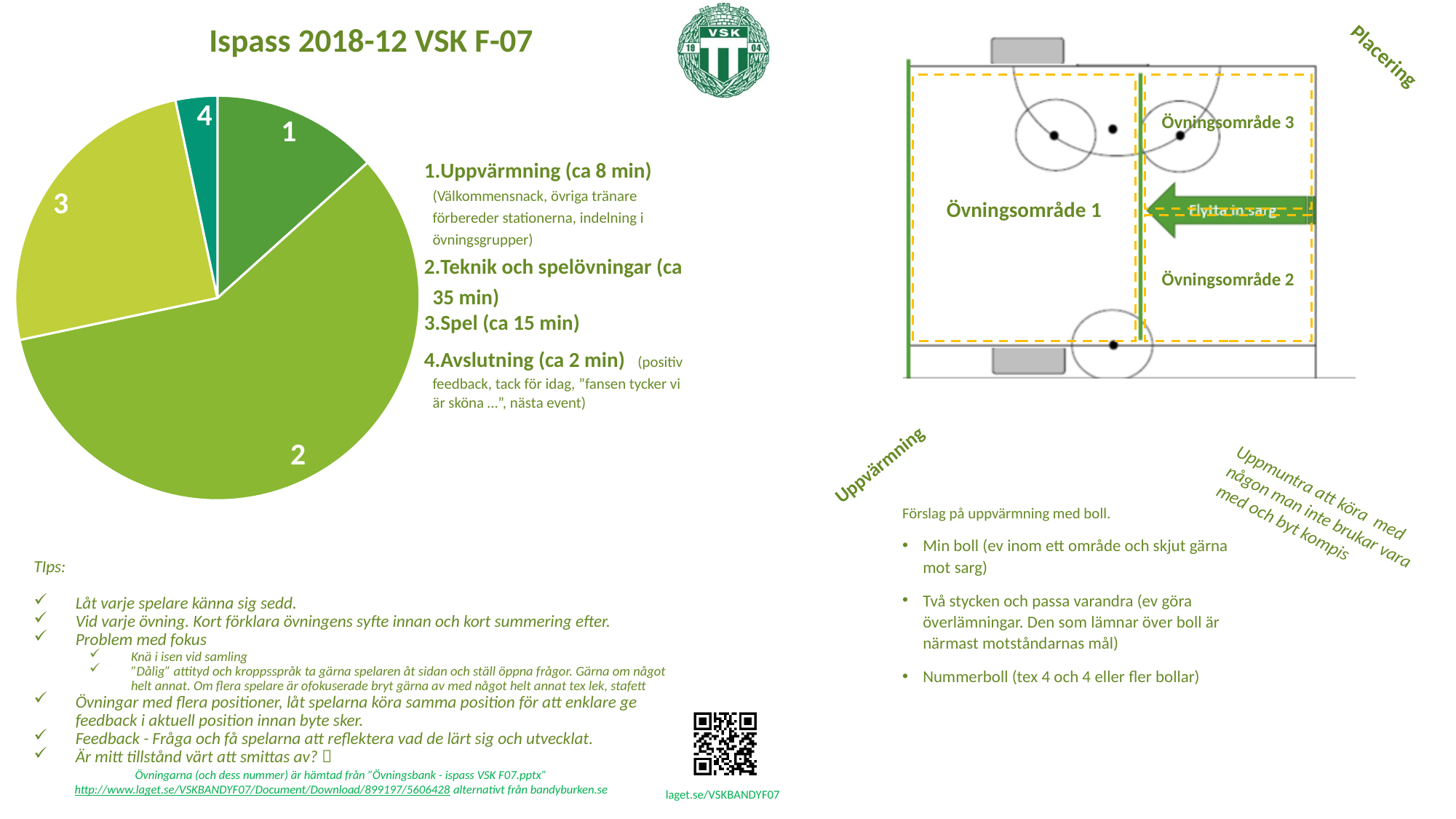
Which slice of the pie chart is the largest? 2 In the pie chart, which slice is larger, slice 1 or slice 4? 1 Does slice 2 of the pie chart take up more or less than half of the pie? more What colour is slice 4 of the pie chart? teal In the pie chart, which slice is larger, slice 2 or slice 3? 2 How many slices does the pie chart have? 4 What is the title of the slide containing the pie chart? Ispass 2018-12 VSK F-07 Which slice of the pie chart is the smallest? 4 What kind of chart is shown on the left of the slide? pie chart In the pie chart, which slice is larger, slice 1 or slice 3? 3